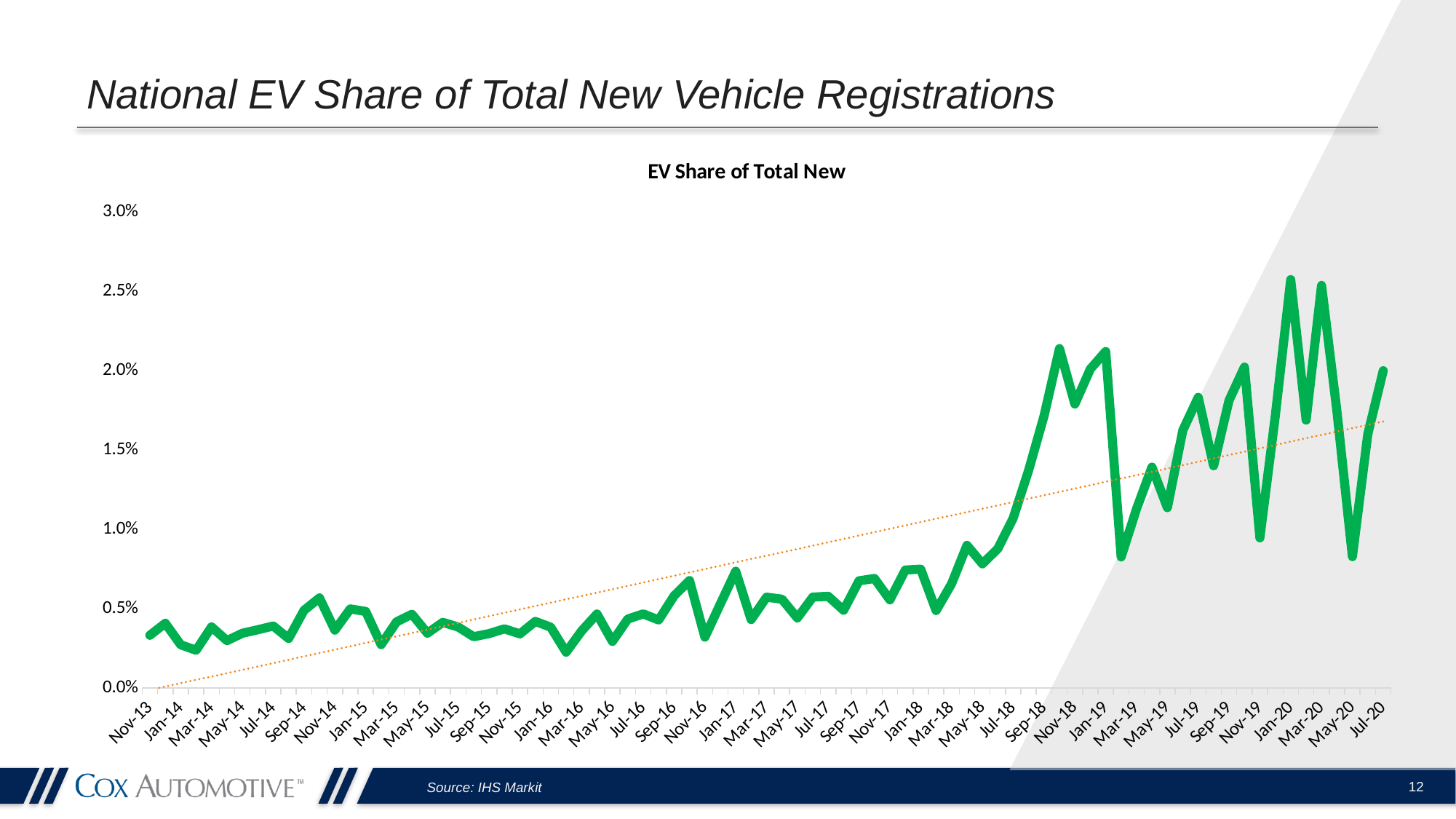
Overall, does the EV share rise or fall from Nov-13 to Jul-20? rise What kind of chart is shown on the slide? line chart What is the highest value shown on the vertical axis? 3.0% Is the value for Nov-18 greater or less than 1.5%? greater Is the value for Mar-19 greater or less than 1.0%? greater Which is larger, the value for Nov-18 or the value for Nov-13? Nov-18 Which is larger, the value for Jul-20 or the value for May-20? Jul-20 What is the title shown above the chart? EV Share of Total New Is the value for May-20 greater or less than 1.0%? less